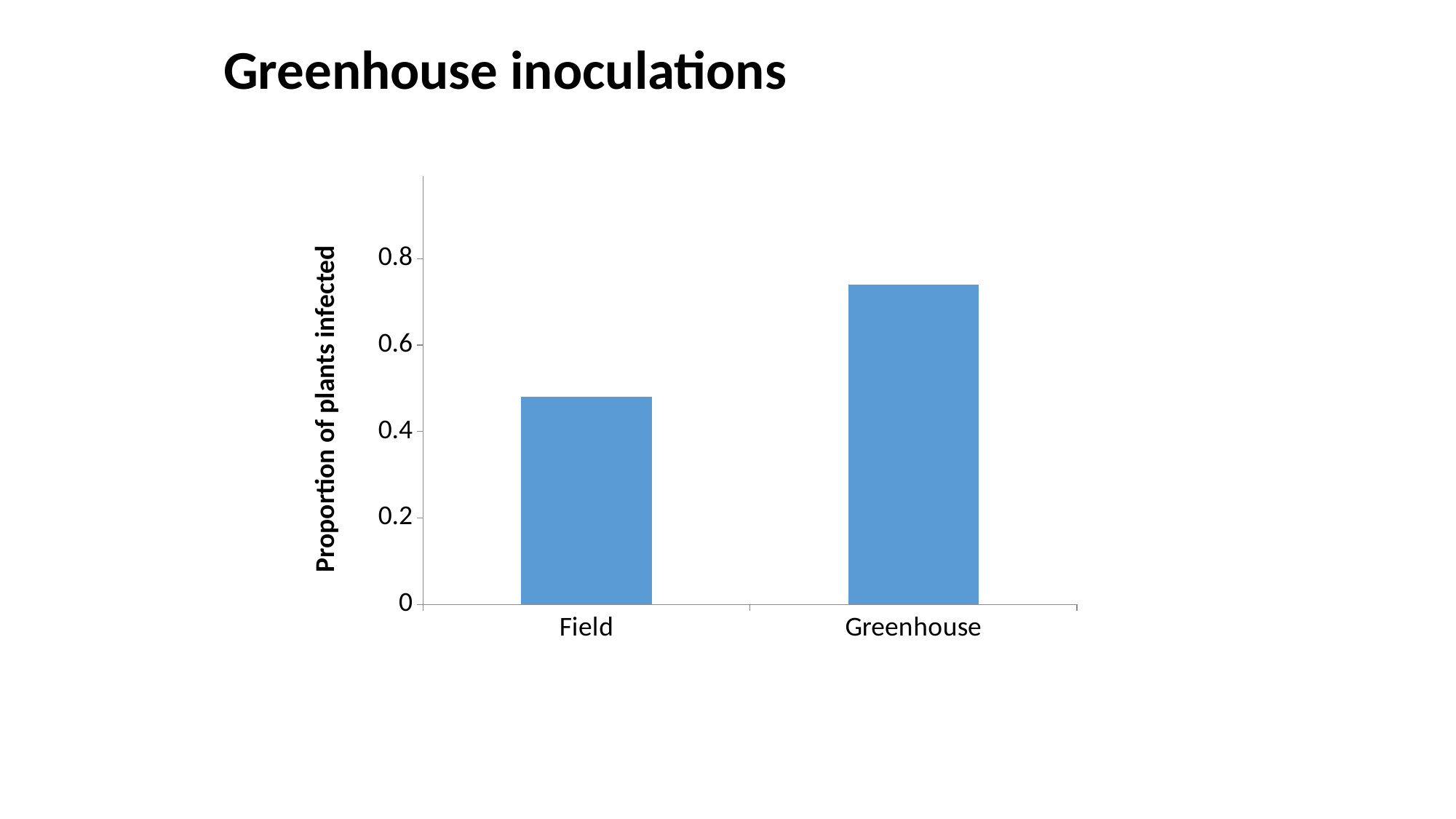
Is the value for Field greater or less than 0.6? less What is the title of the slide containing the chart? Greenhouse inoculations Which category has the highest proportion of plants infected? Greenhouse What is the label of the vertical axis? Proportion of plants infected Is the value for Greenhouse greater or less than 0.6? greater Which category has the lowest proportion of plants infected? Field Do the values rise or fall from Field to Greenhouse along the x axis? rise Is the proportion of plants infected larger for Field or for Greenhouse? Greenhouse Is the value for Field greater or less than 0.4? greater How many categories are plotted on the chart? 2 What kind of chart is shown on the slide? bar chart